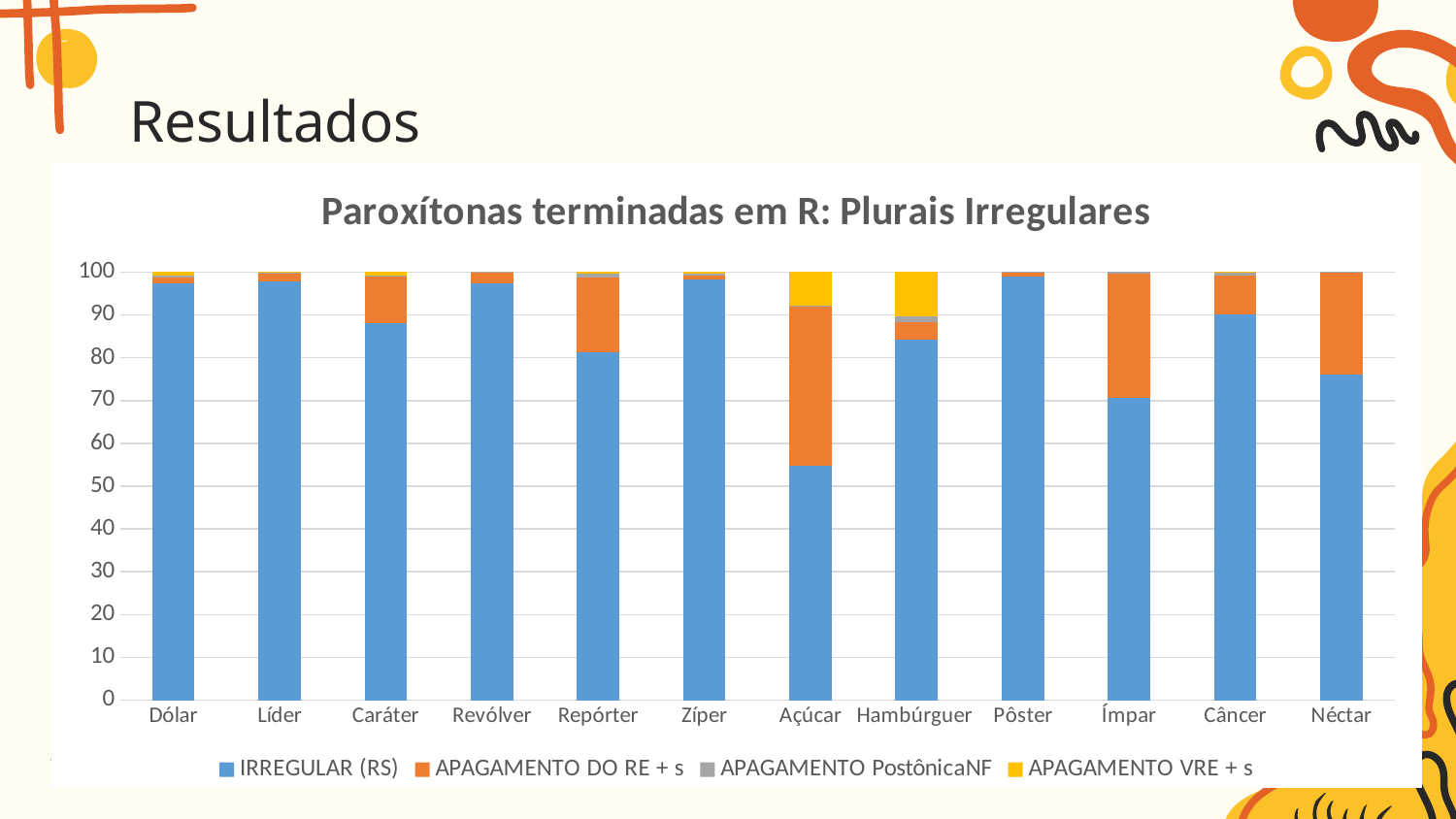
Is the IRREGULAR (RS) value for Açúcar greater or less than 60? less Is the IRREGULAR (RS) value for Repórter greater or less than 90? less What kind of chart is shown on the slide? Stacked bar chart How many series does the chart legend list? 4 What is the total height of the stacked bar for Dólar? 100 Which category has the lowest value for IRREGULAR (RS)? Açúcar What is the title of the chart? Paroxítonas terminadas em R: Plurais Irregulares Is the IRREGULAR (RS) value for Néctar greater or less than 80? less Which category has the largest APAGAMENTO DO RE + s segment? Açúcar Which has a larger IRREGULAR (RS) value, Açúcar or Néctar? Néctar How many categories (words) are shown along the x axis of the chart? 12 Which has a larger IRREGULAR (RS) value, Hambúrguer or Câncer? Câncer